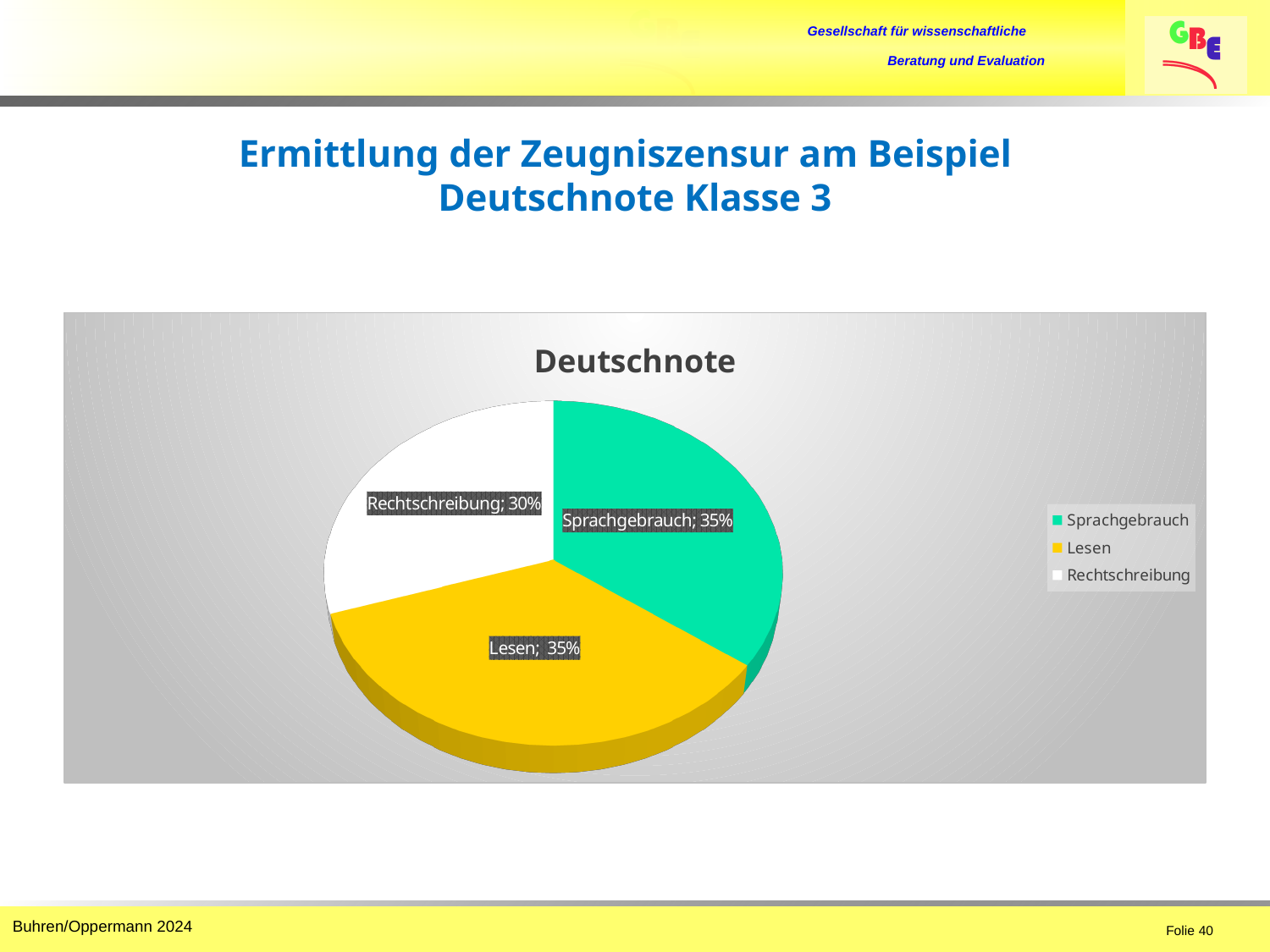
What share of the pie does Lesen have? 35% What share of the pie does Rechtschreibung have? 30% What is the combined share of Sprachgebrauch and Lesen? 70% What is the chart's title? Deutschnote How many entries does the legend list? 3 What is the difference between the shares of Sprachgebrauch and Rechtschreibung? 5% Which slice of the pie is the smallest? Rechtschreibung How many slices does the pie chart have? 3 What kind of chart is shown on the slide? pie chart Which colour represents Lesen in the pie chart? yellow What share of the pie does Sprachgebrauch have? 35% Which is larger, the share of Lesen or the share of Rechtschreibung? Lesen